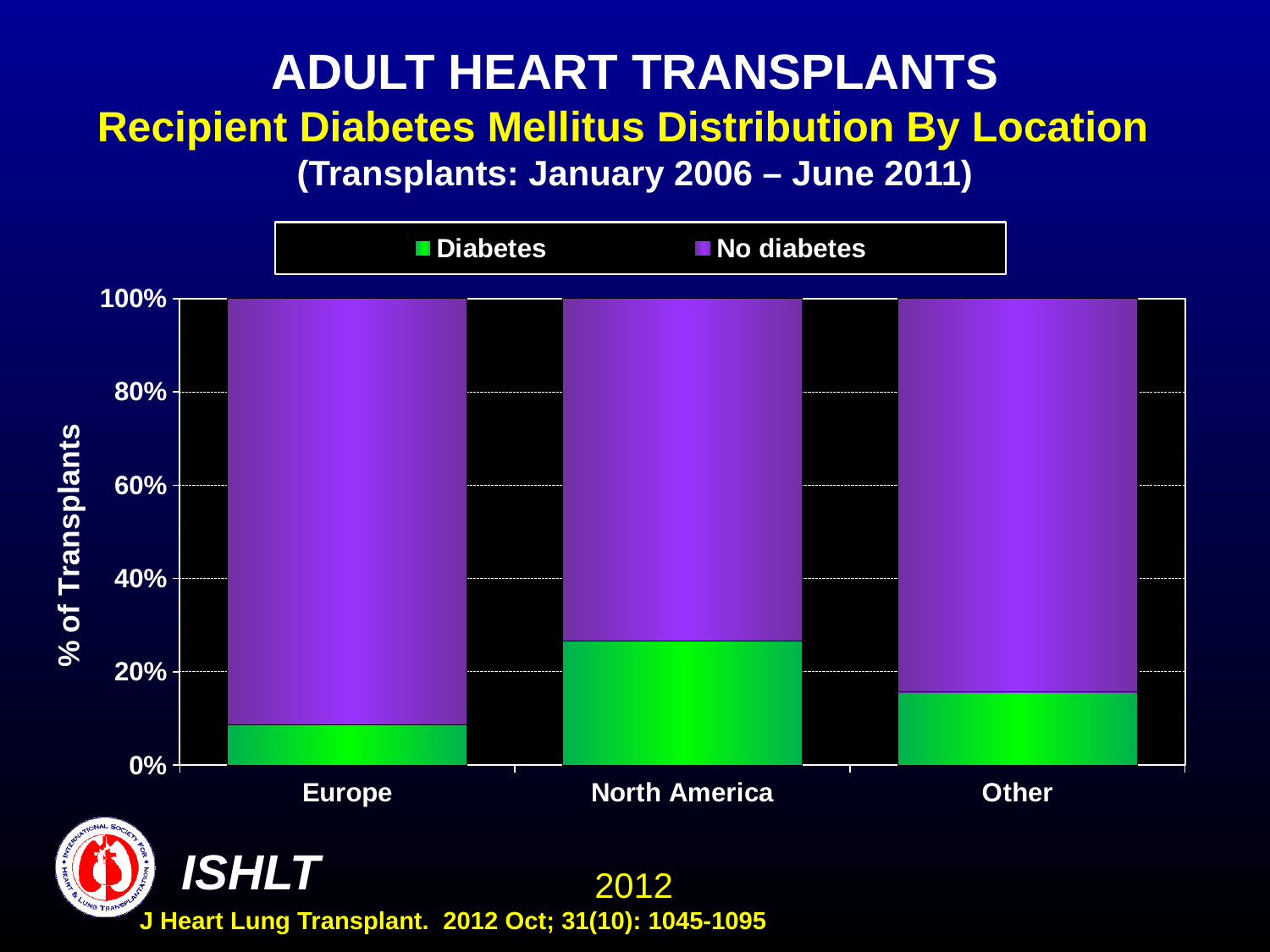
What kind of chart is shown on the slide? stacked bar chart Which colour represents the No diabetes series in the legend? purple Is the Diabetes share for Other greater or less than 20%? less Is the Diabetes share for North America greater or less than 20%? greater Is the Diabetes share for Europe greater or less than 20%? less Which is larger, the Diabetes share for Other or the Diabetes share for Europe? Other How many location categories are shown on the x axis? 3 What is the label on the y axis? % of Transplants Which location has the highest share of recipients with diabetes? North America Which location has the largest share of recipients with no diabetes? Europe Which location has the lowest share of recipients with diabetes? Europe How many series does the legend list? 2